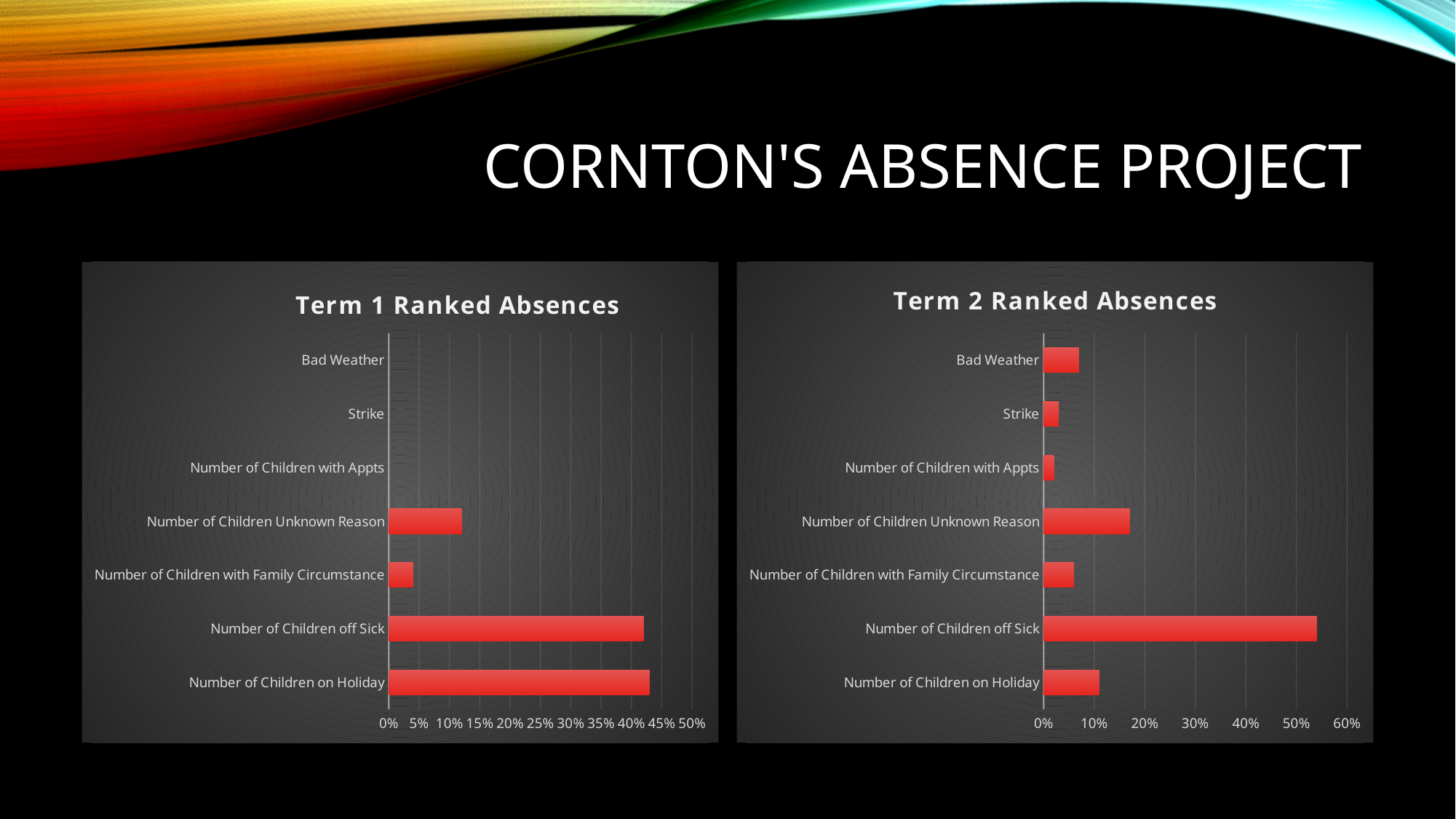
What is the title of the chart on the left of the slide? Term 1 Ranked Absences How many categories are shown on the Term 2 Ranked Absences chart? 7 On the Term 2 Ranked Absences chart, is the value for Number of Children off Sick greater or less than 50%? greater On the Term 2 Ranked Absences chart, is the value for Number of Children Unknown Reason greater or less than 10%? greater On the Term 2 Ranked Absences chart, which is larger: Bad Weather or Strike? Bad Weather What is the highest value shown on the horizontal axis of the Term 2 Ranked Absences chart? 60% On the Term 1 Ranked Absences chart, is the value for Number of Children Unknown Reason greater or less than 10%? greater On the Term 2 Ranked Absences chart, which is larger: Number of Children Unknown Reason or Number of Children on Holiday? Number of Children Unknown Reason On the Term 1 Ranked Absences chart, which is larger: Number of Children Unknown Reason or Number of Children with Family Circumstance? Number of Children Unknown Reason On the Term 2 Ranked Absences chart, which category has the highest value? Number of Children off Sick What kind of chart is the Term 1 Ranked Absences chart? bar chart